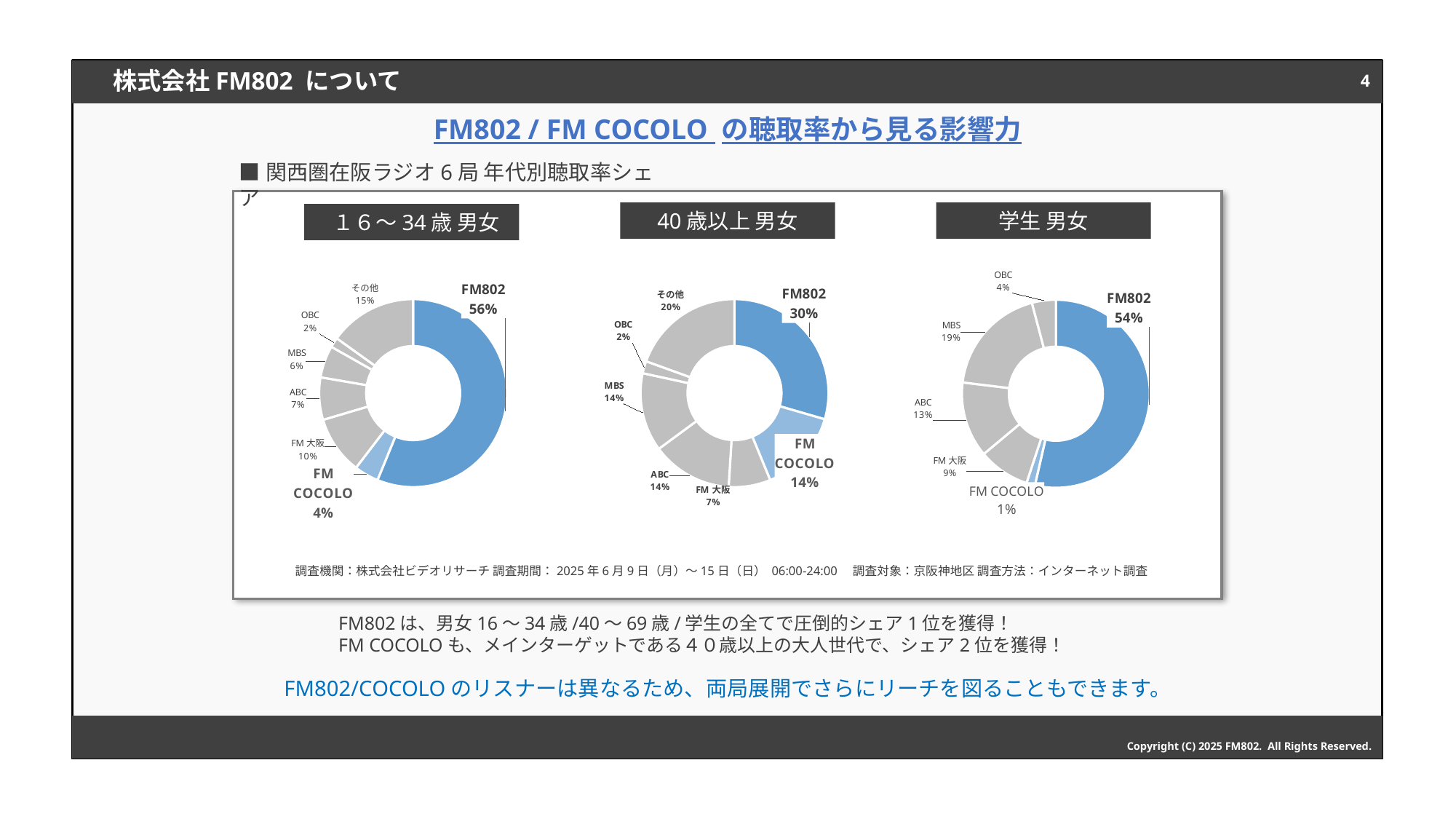
How many slices does the 学生 男女 chart have? 6 In the 学生 男女 chart, what share does MBS have? 19% In the 40歳以上 男女 chart, what share does その他 have? 20% In the 16～34歳 男女 chart, what share does FM802 have? 56% In the 学生 男女 chart, which station has the largest share? FM802 In the 学生 男女 chart, which is larger, the share for ABC or the share for FM大阪? ABC In the 40歳以上 男女 chart, what is the difference between the FM802 share and the FM COCOLO share? 16% How many slices does the 40歳以上 男女 chart have? 7 In the 16～34歳 男女 chart, which is larger, the share for FM大阪 or the share for ABC? FM大阪 What kind of chart is used for the 16～34歳 男女 data? Donut (pie) chart In the 16～34歳 男女 chart, which station has the smallest share? OBC In the 40歳以上 男女 chart, what share does FM COCOLO have? 14%